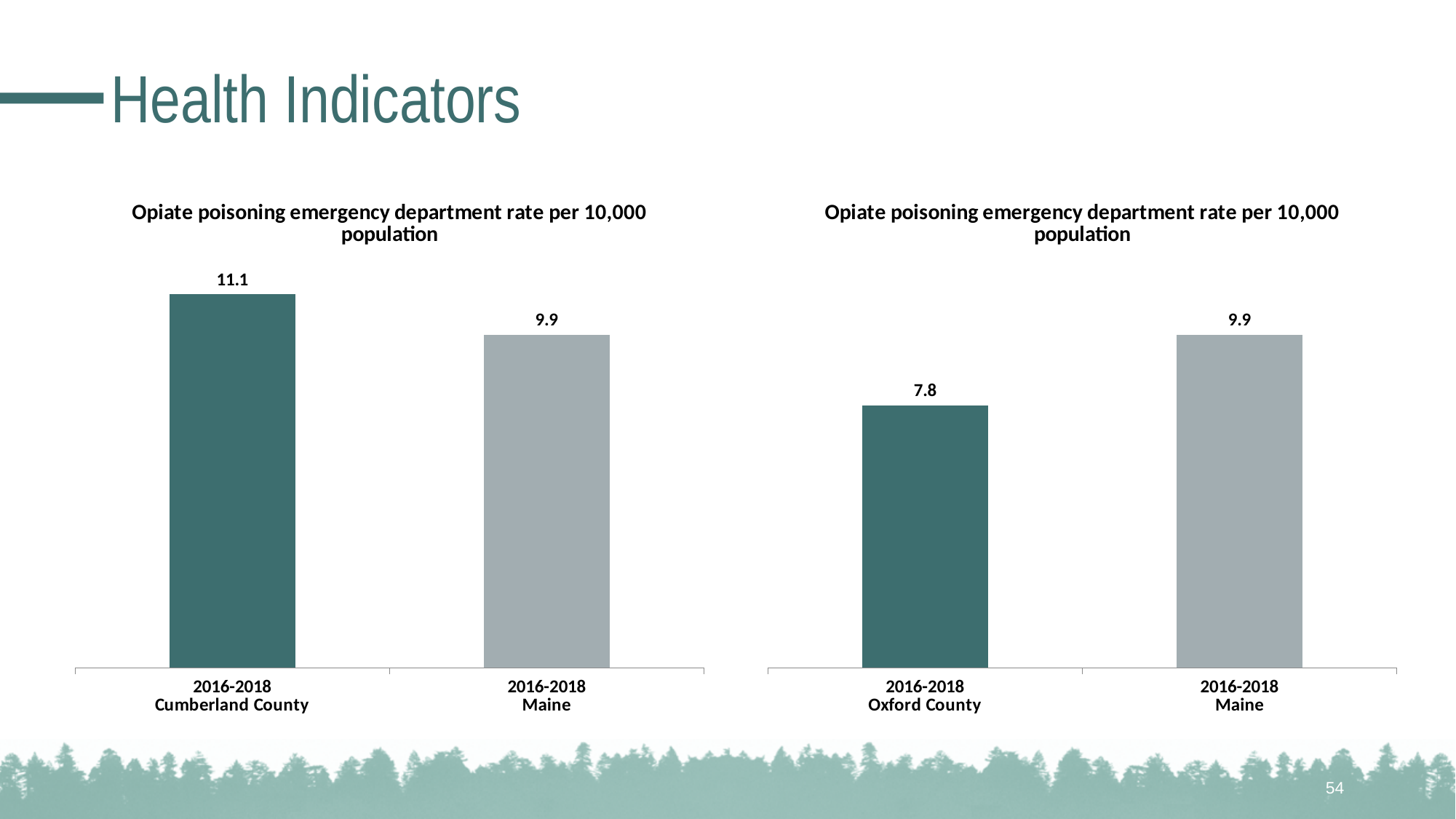
In the left chart (Cumberland County), which category has the higher rate? 2016-2018 Cumberland County In the left chart (Cumberland County), what is the opiate poisoning emergency department rate per 10,000 population for 2016-2018 Cumberland County? 11.1 How many bars are plotted in the left chart (Cumberland County)? 2 In the right chart (Oxford County), which category has the lower rate? 2016-2018 Oxford County In the right chart (Oxford County), is the rate for Oxford County or for Maine larger? Maine In the right chart (Oxford County), what is the difference between the Maine rate and the Oxford County rate? 2.1 In the right chart (Oxford County), what is the opiate poisoning emergency department rate per 10,000 population for 2016-2018 Oxford County? 7.8 In the left chart (Cumberland County), what is the rate for 2016-2018 Maine? 9.9 In the left chart (Cumberland County), what is the difference between the Cumberland County rate and the Maine rate? 1.2 What kind of chart is the right chart (Oxford County)? Bar chart In the right chart (Oxford County), what is the rate for 2016-2018 Maine? 9.9 What is the title of the left chart? Opiate poisoning emergency department rate per 10,000 population